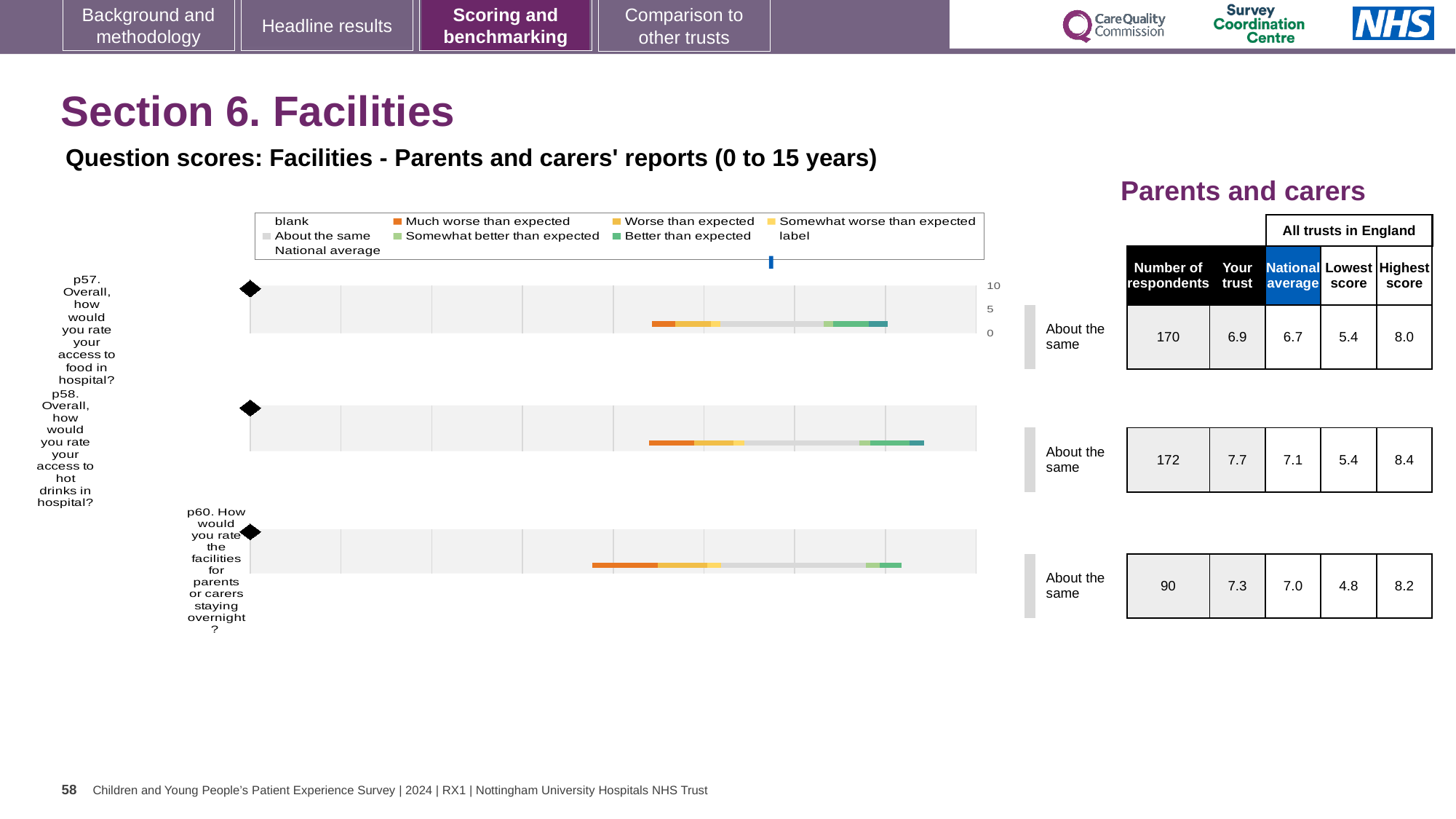
For p57, which is larger: the 'Your trust' score or the national average? Your trust What is the 'Your trust' score for p57 (access to food in hospital)? 6.9 How many survey questions (p57, p58, p60) are plotted on the slide? 3 What is the highest score across all trusts in England for p58? 8.4 What is the highest value shown on the score axis of the charts? 10 For p58, what is the difference between the 'Your trust' score and the national average? 0.6 How many respondents answered p60 (facilities for parents or carers staying overnight)? 90 What is the national average score for p58 (access to hot drinks in hospital)? 7.1 Which question has the highest 'Your trust' score? p58 Which question has the lowest 'Lowest score' across all trusts in England? p60 What benchmark category is shown for all three questions on this slide? About the same What kind of chart is used to show the question scores on this slide? bar chart